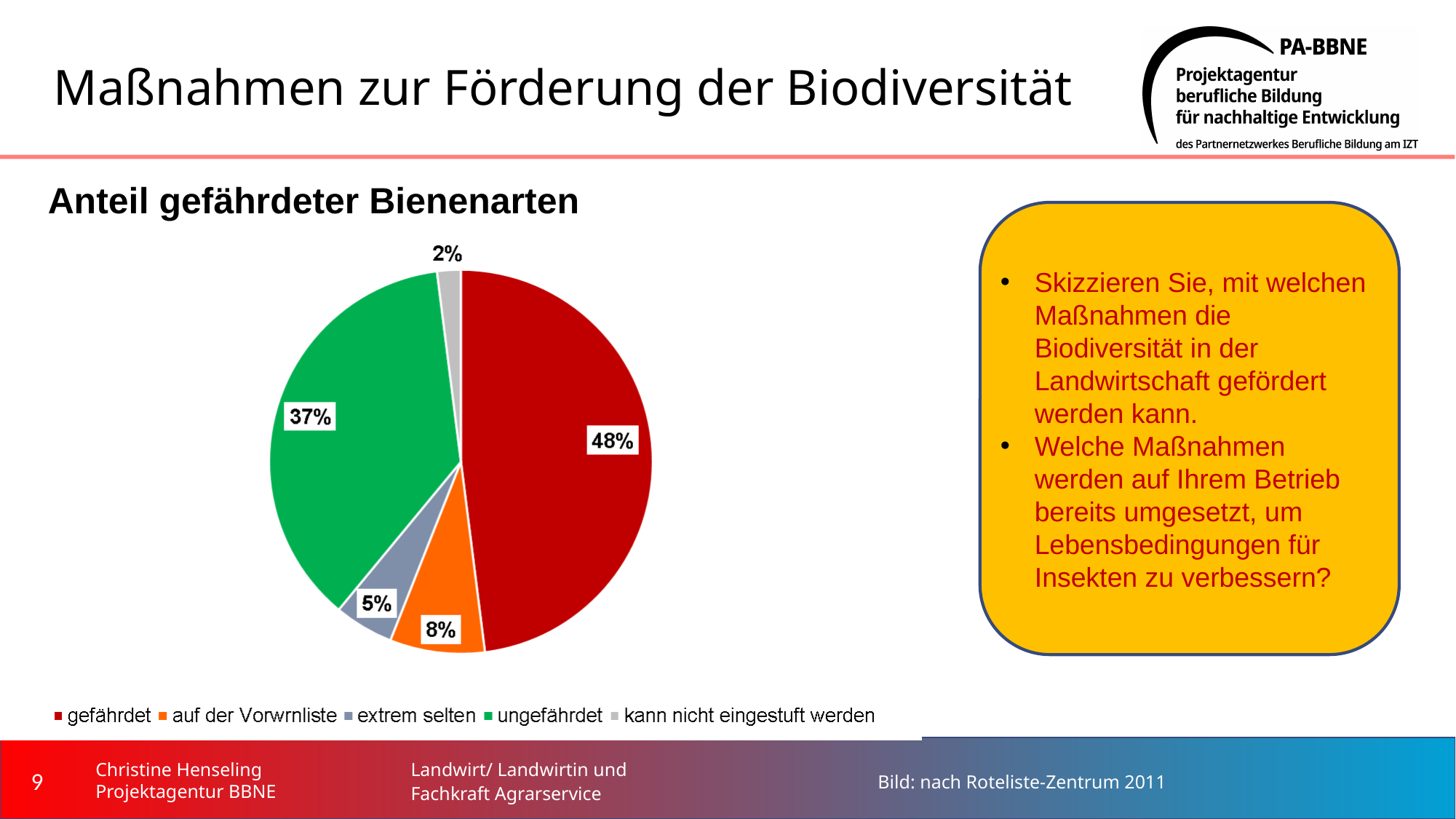
What percentage does the "ungefährdet" slice show? 37% What share of bee species is labelled "gefährdet" in the pie chart? 48% Which category has the smallest slice of the pie? kann nicht eingestuft werden What percentage is shown for "extrem selten"? 5% What share is given for "kann nicht eingestuft werden"? 2% Which category has the largest slice of the pie? gefährdet What is the difference in percentage points between "gefährdet" and "ungefährdet"? 11 What colour is the "ungefährdet" slice? green How many slices does the pie chart have? 5 What type of chart is shown on the slide? pie chart What is the value of the "auf der Vorwrnliste" slice? 8% Which is larger, the "auf der Vorwrnliste" slice or the "extrem selten" slice? auf der Vorwrnliste